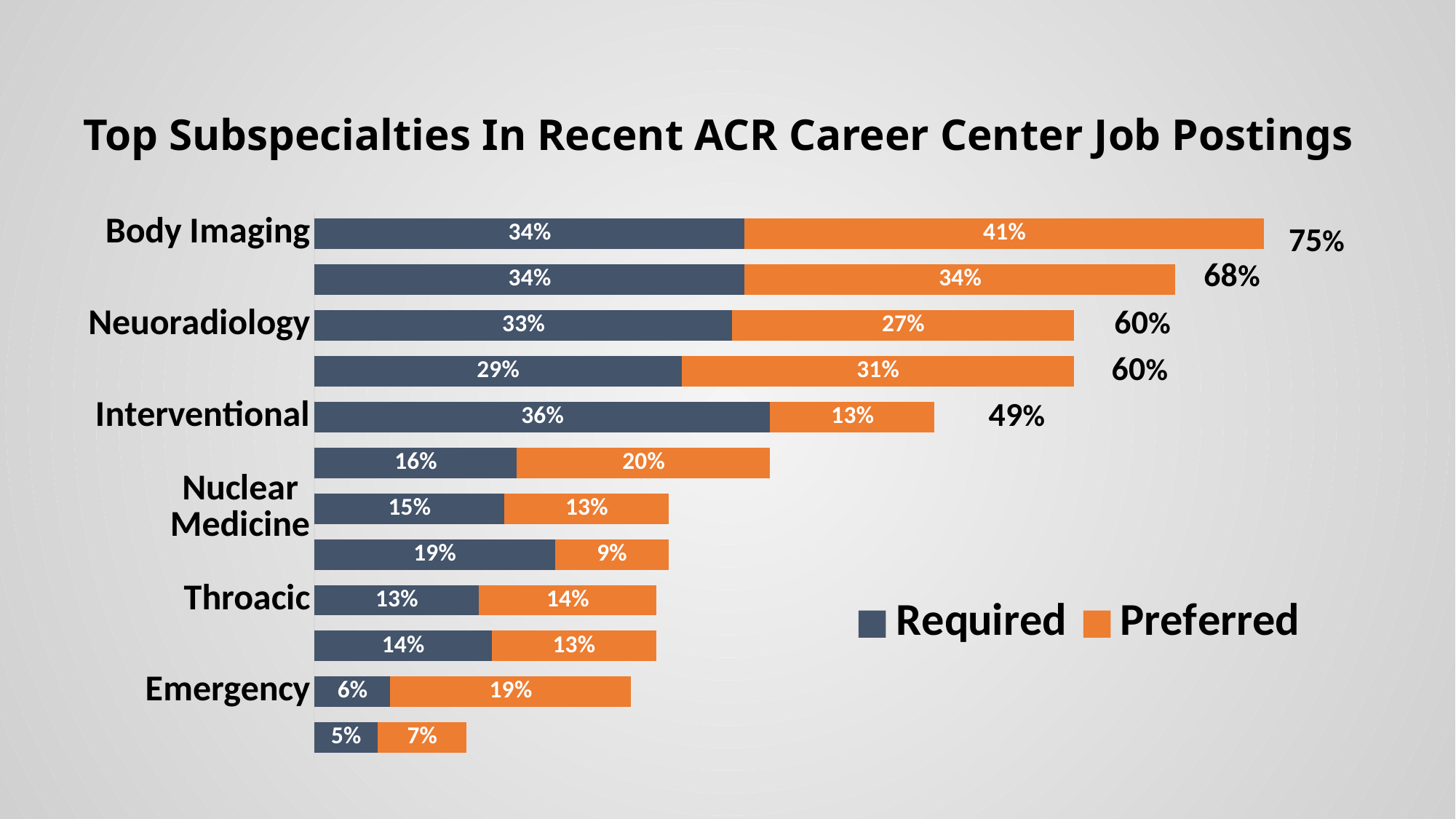
Which labeled subspecialty has the highest total bar? Body Imaging What kind of chart is shown on the slide? Stacked bar chart What is the Required value for Body Imaging? 34% What is the Preferred value for Body Imaging? 41% How many series does the legend list? 2 What is the difference between the Preferred and Required values for Body Imaging? 7% What is the Preferred value for Interventional? 13% Which is larger, the Required value for Interventional or the Required value for Body Imaging? Interventional What is the Required value for Emergency? 6% What is the Required value for Neuroradiology? 33% What is the Preferred value for Throacic? 14% What is the total of the stacked bar for Body Imaging? 75%